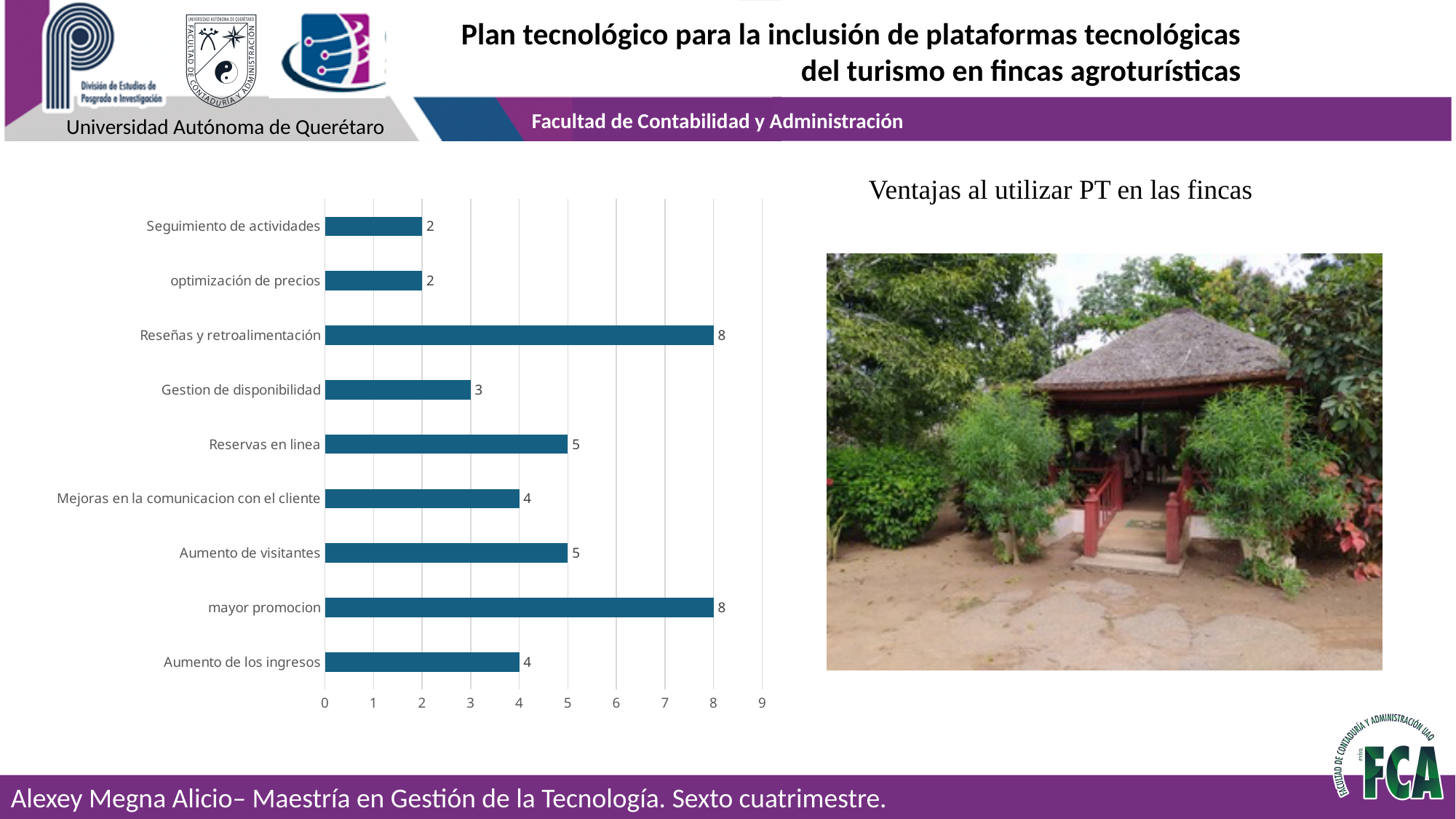
What is the value for Gestion de disponibilidad? 3 What is the value for Reseñas y retroalimentación? 8 Which categories have the lowest value? Seguimiento de actividades and optimización de precios What kind of chart is shown on the slide? bar chart What is the value for Reservas en linea? 5 Is the value for Aumento de visitantes greater or less than 3? greater What is the value for Aumento de los ingresos? 4 What is the difference between the values for mayor promocion and Gestion de disponibilidad? 5 Which categories have the highest value? Reseñas y retroalimentación and mayor promocion What is the title shown above the photo next to the chart? Ventajas al utilizar PT en las fincas How many categories are shown in the chart? 9 Which is larger, the value for Reservas en linea or the value for Mejoras en la comunicacion con el cliente? Reservas en linea